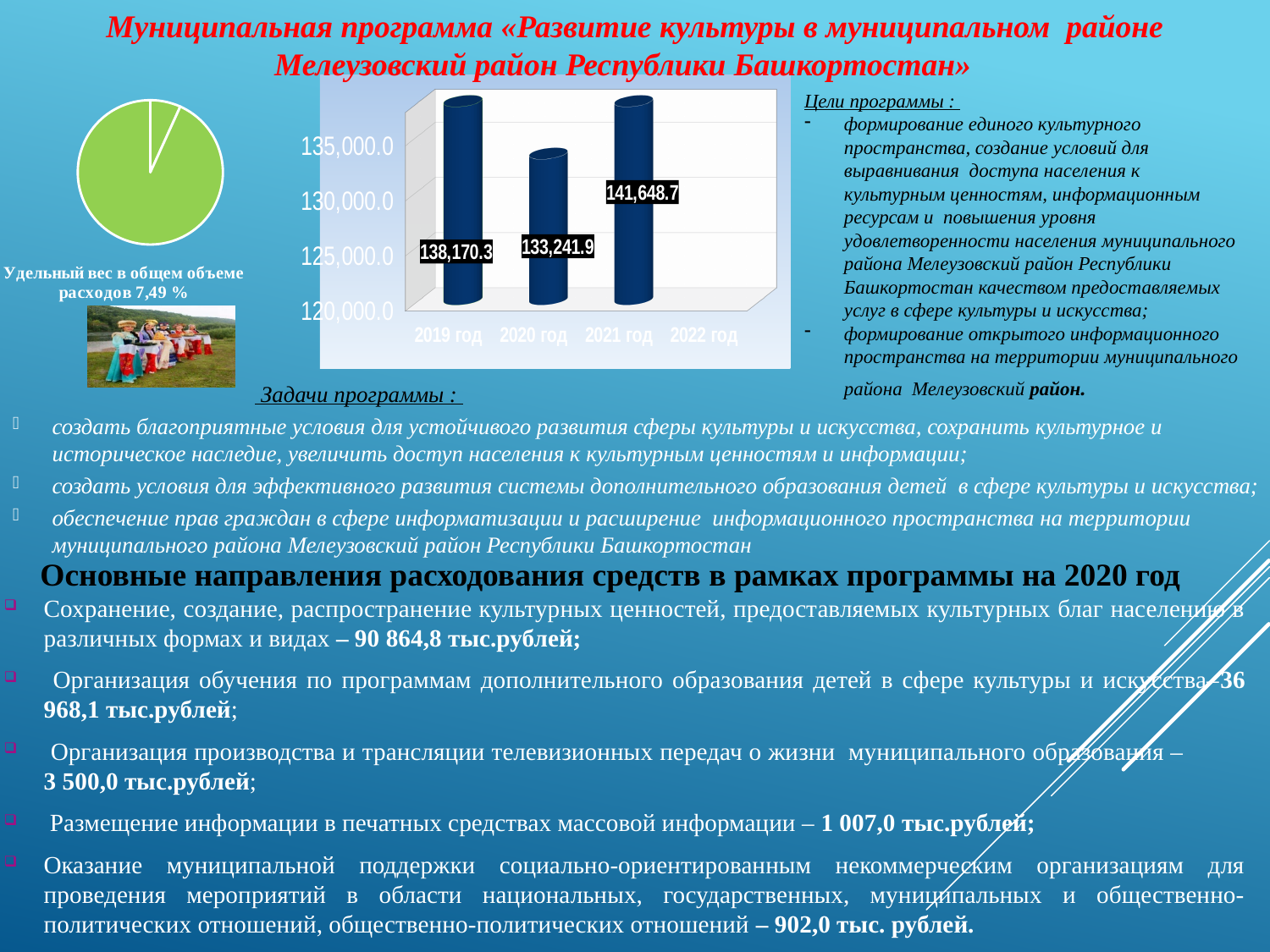
In the bar chart, which year has the lowest labelled value? 2020 год In the bar chart, is the value for 2020 год greater or less than 130,000.0? greater What kind of chart is the green chart on the left of the slide? pie chart In the bar chart, what is the difference between the values for 2019 год and 2020 год? 4,928.4 In the bar chart, what is the value for 2020 год? 133,241.9 In the bar chart, which year has the highest labelled value? 2021 год In the bar chart, which is larger, the value for 2019 год or the value for 2020 год? 2019 год In the bar chart, what is the value for 2021 год? 141,648.7 What kind of chart is the chart in the middle of the slide showing values by year? bar chart In the bar chart, how many bars have data labels? 3 In the bar chart, what is the value for 2019 год? 138,170.3 In the bar chart, what is the difference between the values for 2021 год and 2019 год? 3,478.4